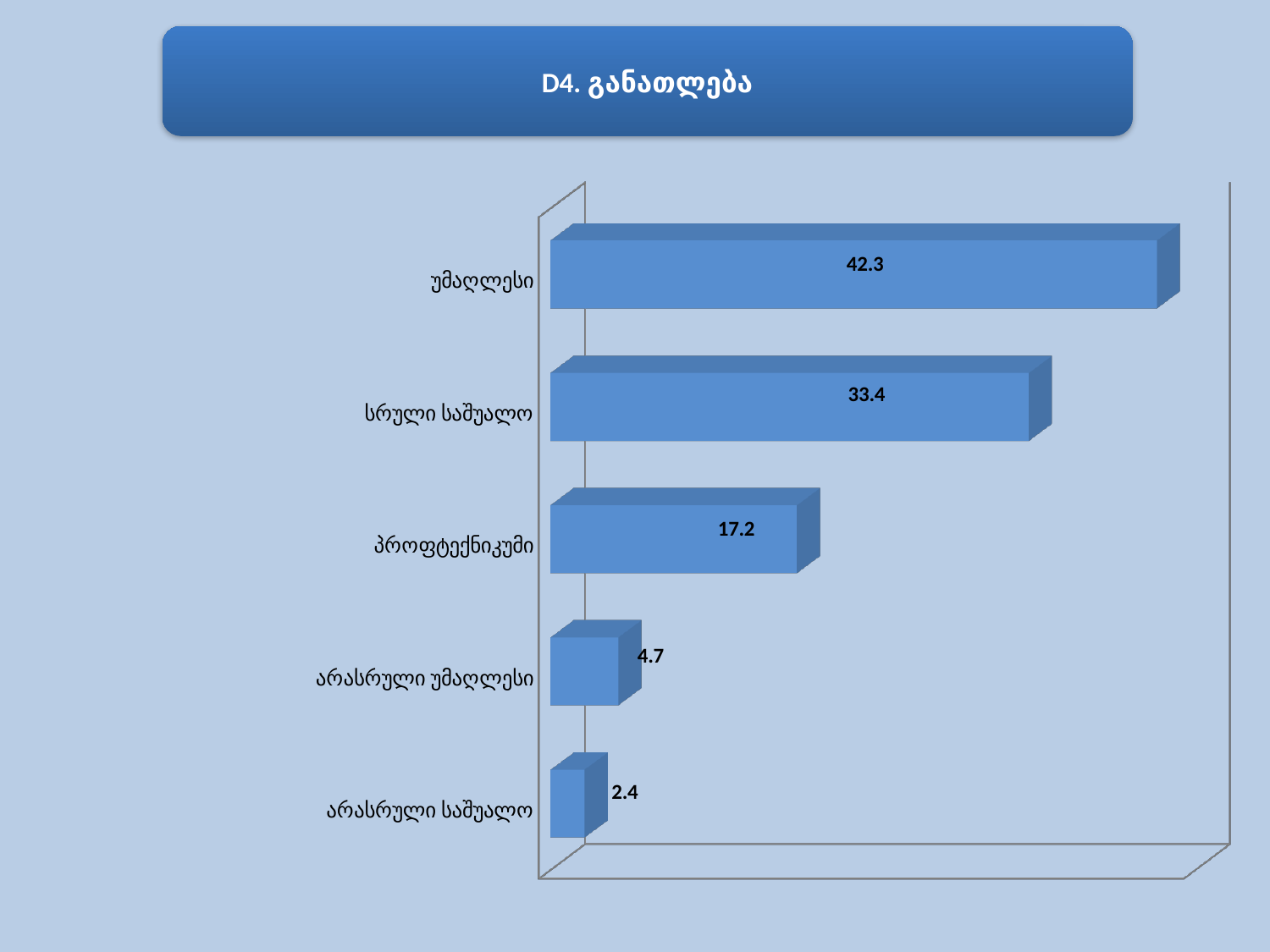
What is the value for პროფტექნიკუმი? 17.2 What is the value for სრული საშუალო? 33.4 How many categories are shown in the chart? 5 What is the value for უმაღლესი? 42.3 What is the value for არასრული უმაღლესი? 4.7 What kind of chart is shown on the slide? Bar chart What is the title of the slide? D4. განათლება Which category has the highest value? უმაღლესი What is the difference between the values for უმაღლესი and სრული საშუალო? 8.9 What is the value for არასრული საშუალო? 2.4 Which category has the lowest value? არასრული საშუალო Which is larger, the value for პროფტექნიკუმი or the value for არასრული უმაღლესი? პროფტექნიკუმი